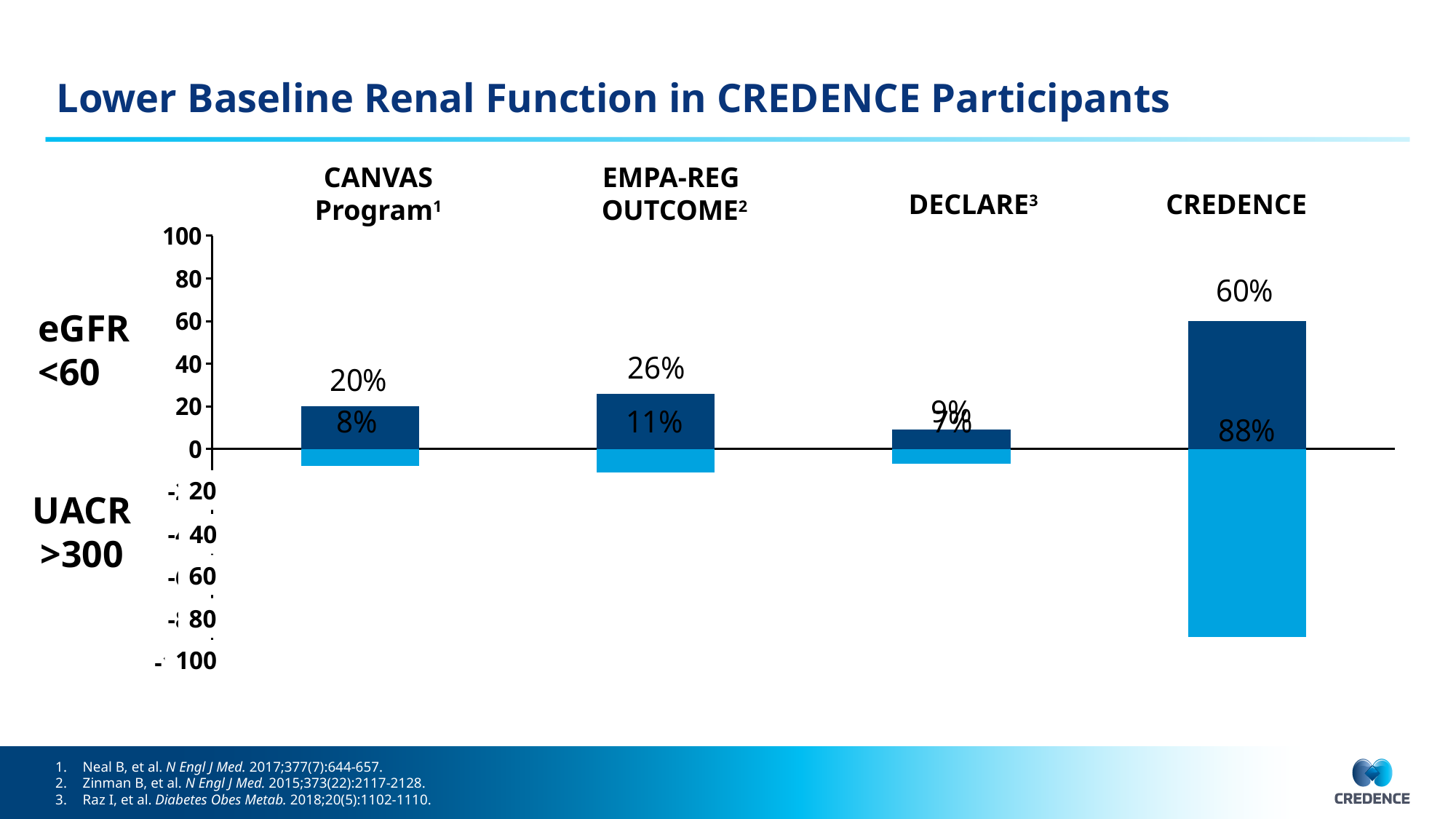
How many trials are compared in the chart? 4 Which trial has the lowest proportion of participants with eGFR <60? DECLARE Which trial has the highest proportion of participants with eGFR <60? CREDENCE What is the UACR >300 value shown for EMPA-REG OUTCOME? 11% What is the eGFR <60 value shown for the CANVAS Program? 20% How many percentage points higher is the eGFR <60 proportion in CREDENCE than in the CANVAS Program? 40 percentage points What is the title of the slide? Lower Baseline Renal Function in CREDENCE Participants Which has a larger eGFR <60 proportion, EMPA-REG OUTCOME or the CANVAS Program? EMPA-REG OUTCOME What is the UACR >300 value shown for the CANVAS Program? 8% What percentage of CREDENCE participants had UACR >300? 88% What type of chart is shown on the slide? Bar chart What percentage of CREDENCE participants had eGFR <60? 60%